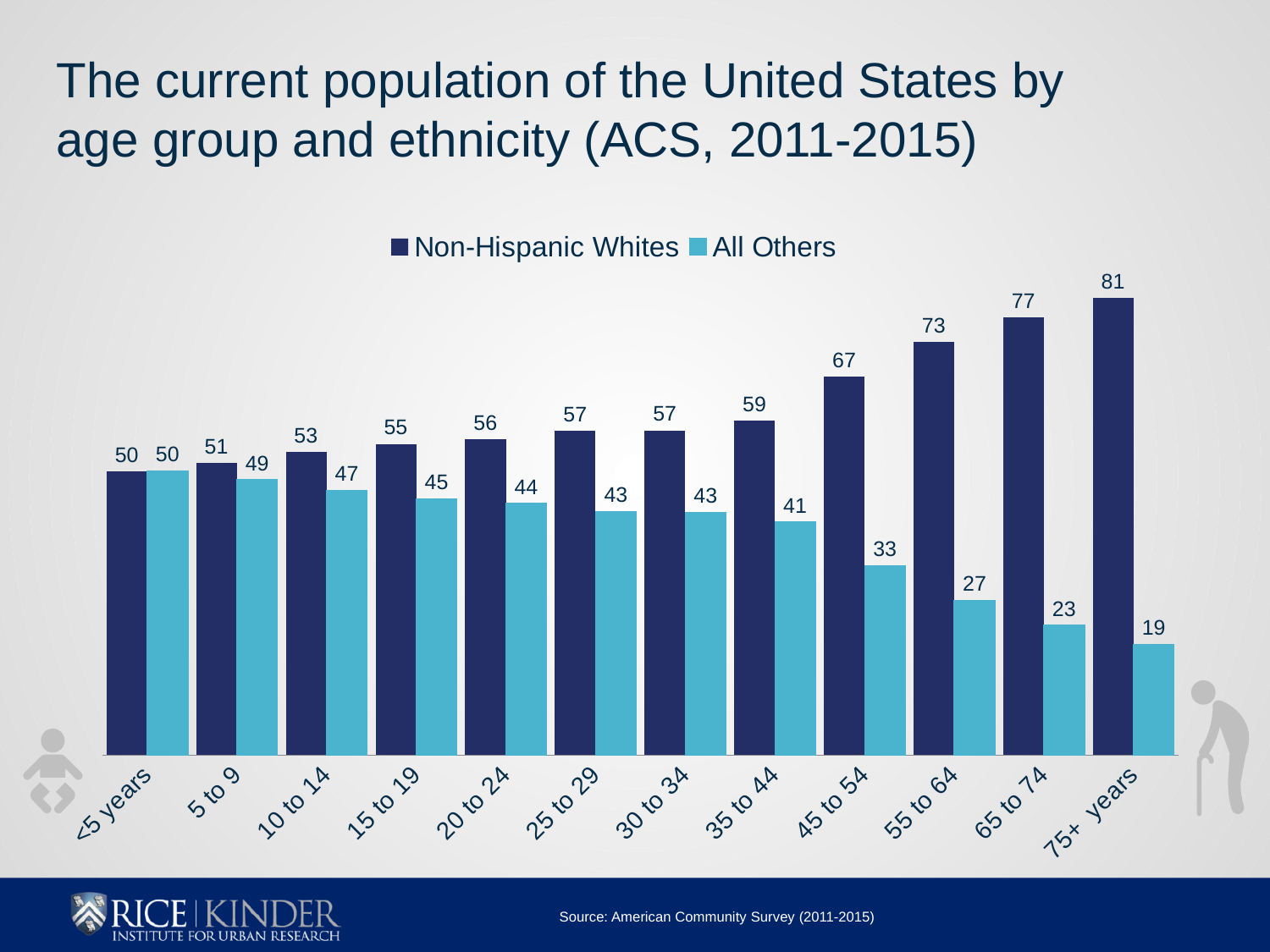
What is the difference between the Non-Hispanic Whites and All Others values in the 65 to 74 age group? 54 What is the value for Non-Hispanic Whites in the 45 to 54 age group? 67 What is the value for Non-Hispanic Whites in the <5 years age group? 50 How many age groups are shown on the x axis? 12 Do the All Others values rise or fall as age group increases along the x axis? Fall Which is larger in the 35 to 44 age group: Non-Hispanic Whites or All Others? Non-Hispanic Whites Which age group has the lowest value for All Others? 75+ years What are the two series named in the legend? Non-Hispanic Whites and All Others Which age group has the highest value for Non-Hispanic Whites? 75+ years What kind of chart is shown on the slide? Bar chart How many series does the legend list? 2 What is the value for All Others in the 20 to 24 age group? 44